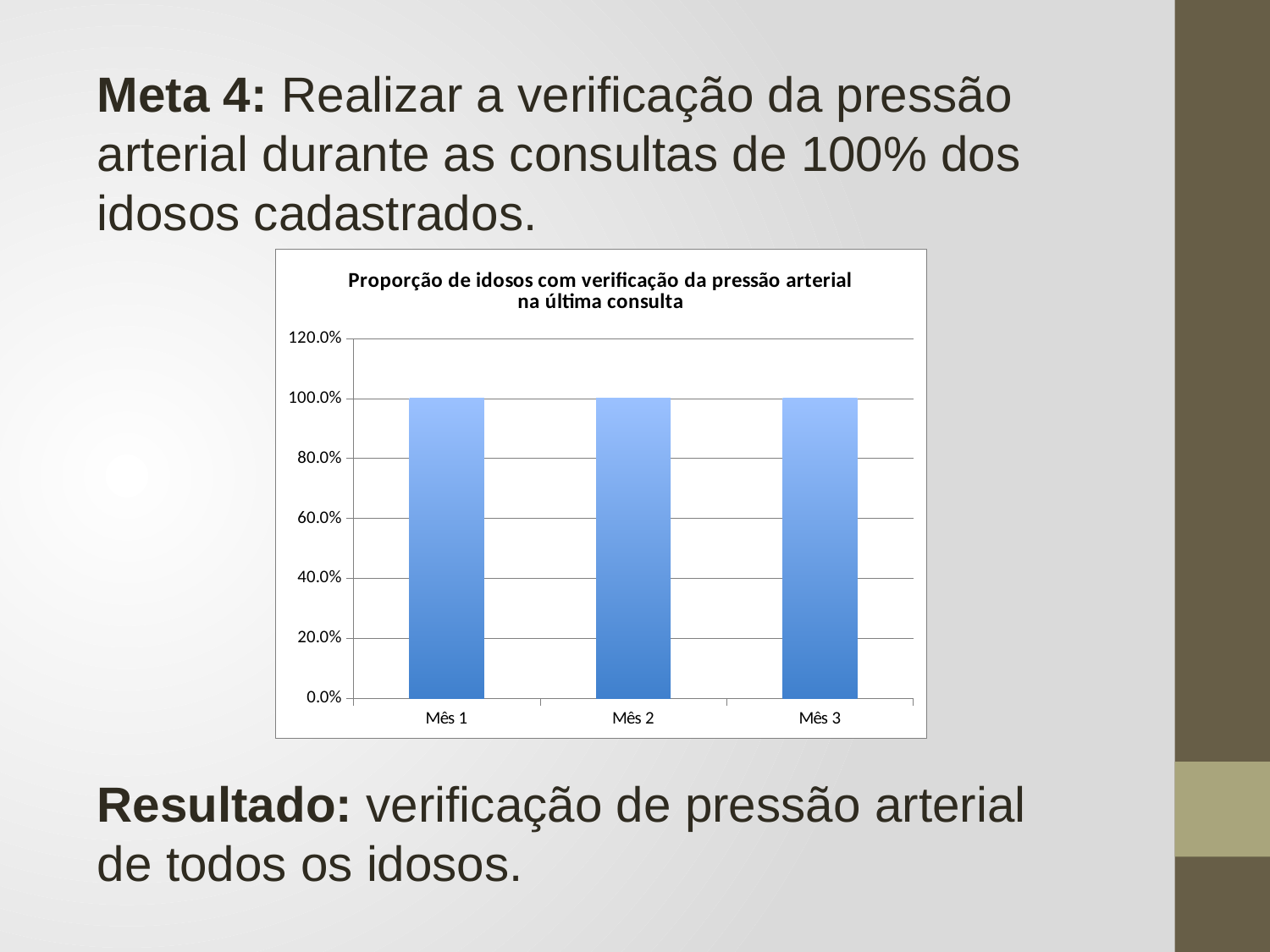
What is the label of the first category on the x axis? Mês 1 What type of chart is shown on the slide? bar chart What is the value for Mês 2? 100.0% What is the value for Mês 3? 100.0% What is the difference between the values for Mês 1 and Mês 3? 0.0% What is the title of the chart? Proporção de idosos com verificação da pressão arterial na última consulta What is the highest value shown on the vertical axis of the chart? 120.0% What is the value for Mês 1? 100.0% Is the value for Mês 2 greater or less than 80.0%? greater How many categories (months) are shown on the x axis of the chart? 3 Do the values rise, fall, or stay the same from Mês 1 to Mês 3? stay the same Is the value for Mês 3 greater or less than 120.0%? less